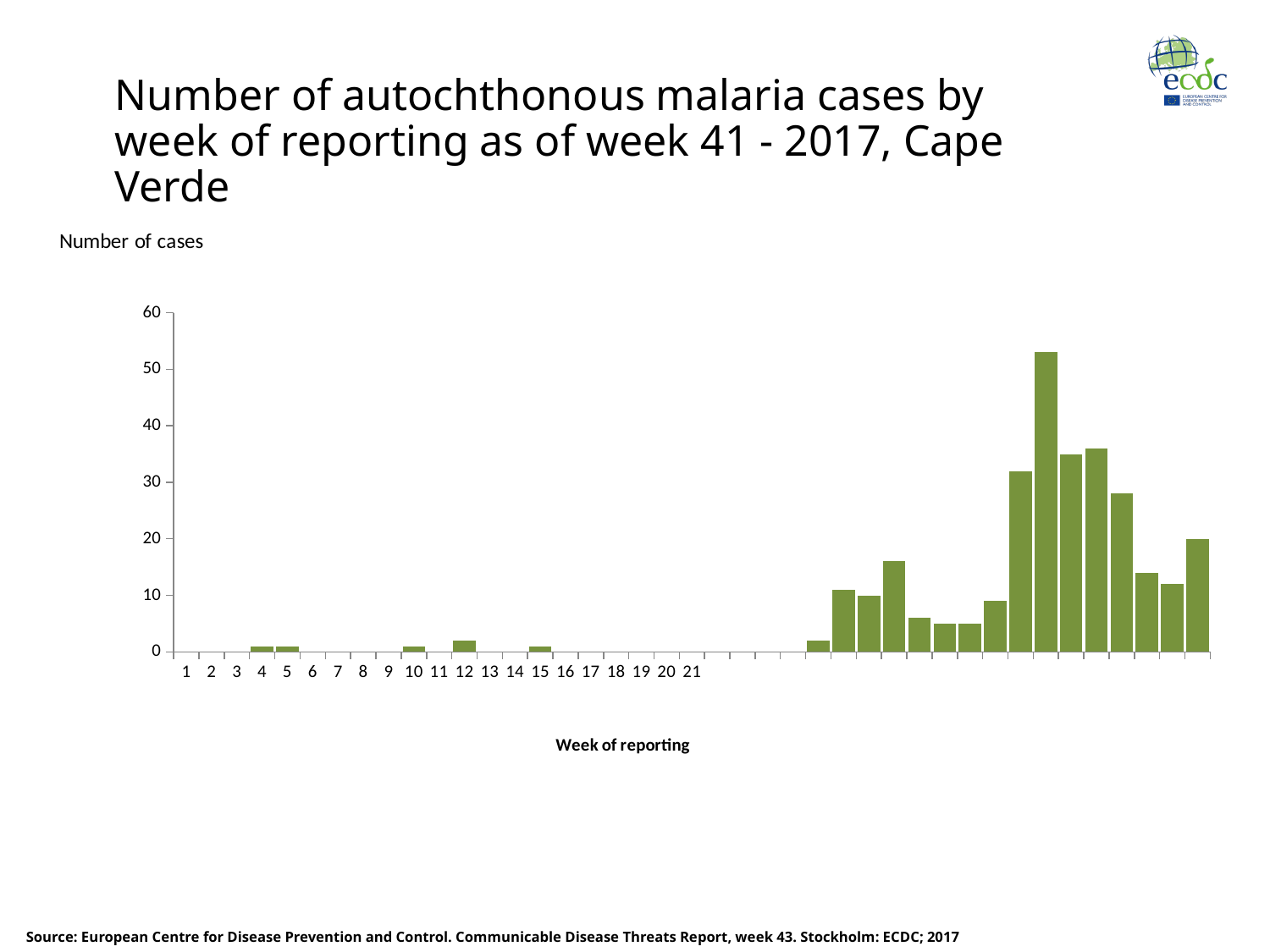
Is the value of the tallest bar greater or less than 50? greater What is the title of the chart? Number of autochthonous malaria cases by week of reporting as of week 41 - 2017, Cape Verde Is the value of the tallest bar greater or less than 60? less What kind of chart is shown on the slide? bar chart Which has more cases, week 12 or week 4? week 12 Is the value for week 12 greater or less than 10? less What is the label of the x axis? Week of reporting Which has more cases, week 12 or week 15? week 12 How many week labels are printed on the x axis? 21